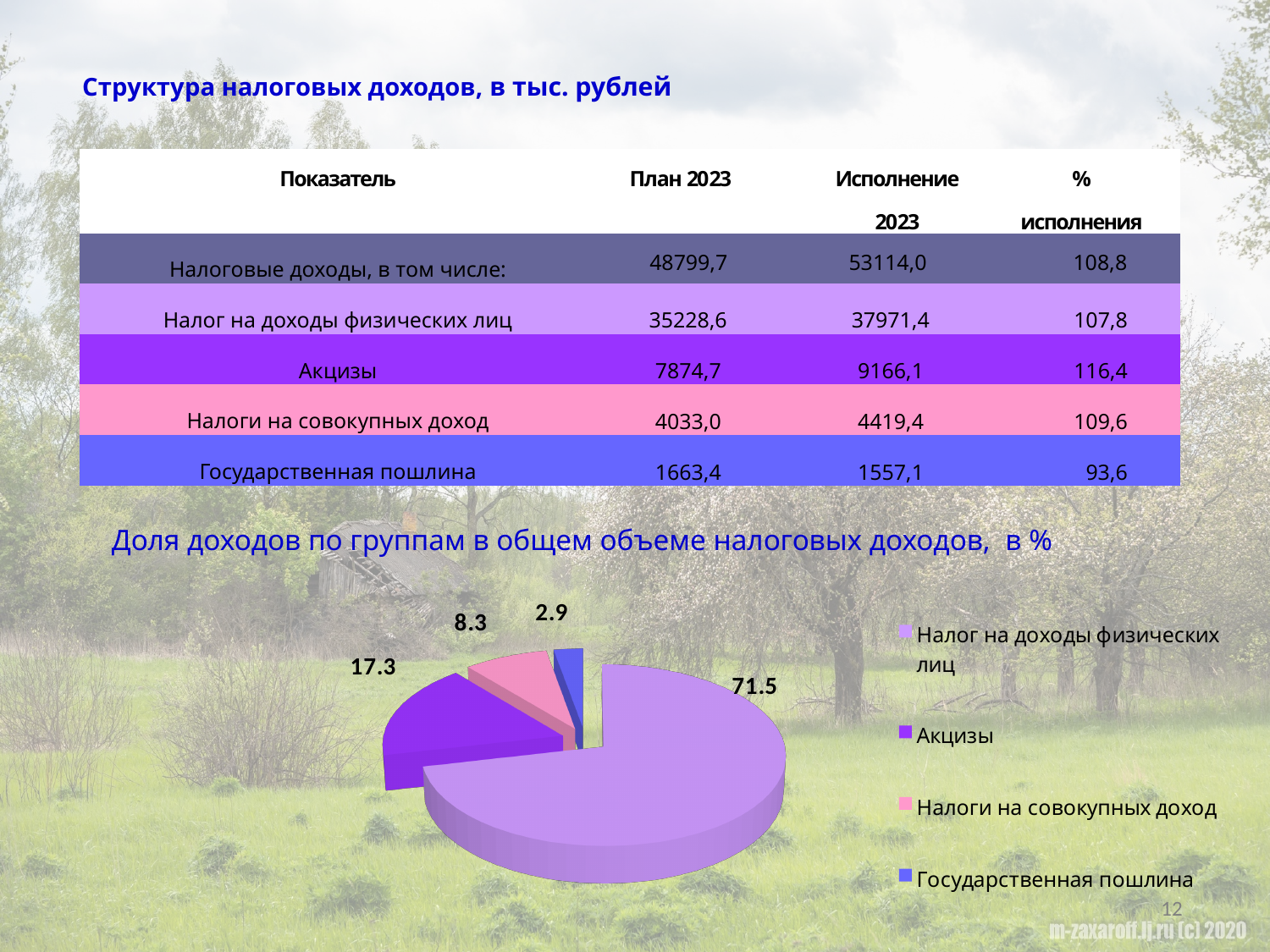
In the pie chart, what is the share for Акцизы? 17.3 In the pie chart, what is the share for Государственная пошлина? 2.9 Which category has the smallest slice in the pie chart? Государственная пошлина In the pie chart, what is the share for Налог на доходы физических лиц? 71.5 What is the title shown above the pie chart? Доля доходов по группам в общем объеме налоговых доходов, в % Which is larger in the pie chart: the share for Акцизы or the share for Государственная пошлина? Акцизы What is the difference between the shares for Акцизы and Налоги на совокупных доход in the pie chart? 9.0 In the pie chart, what is the share for Налоги на совокупных доход? 8.3 Which category has the largest slice in the pie chart? Налог на доходы физических лиц How many entries does the pie chart legend list? 4 What kind of chart is shown on the slide? pie chart How many slices does the pie chart have? 4